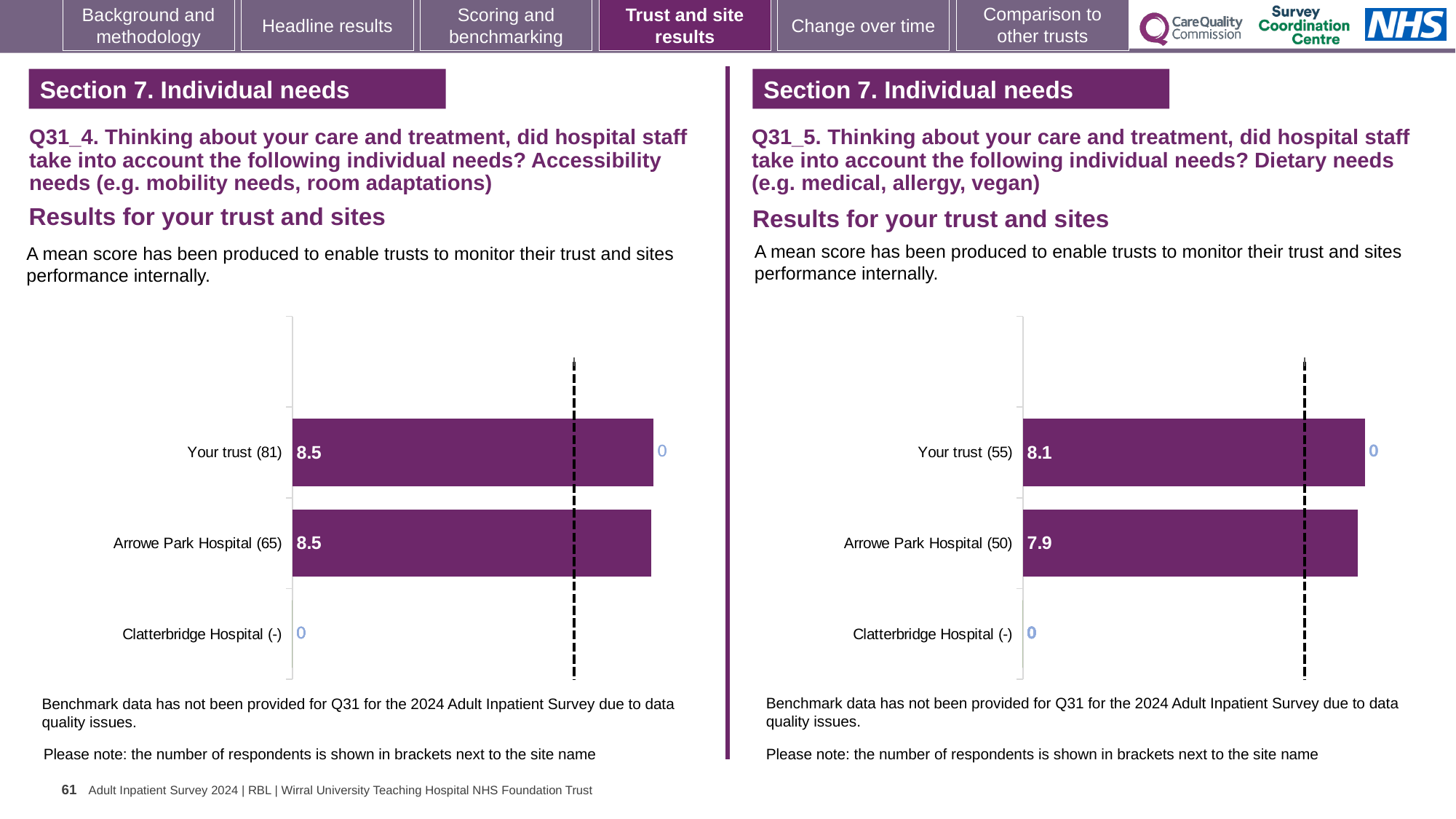
On the right chart (Q31_5, Dietary needs), which has the higher mean score: Your trust (55) or Arrowe Park Hospital (50)? Your trust (55) On the right chart (Q31_5, Dietary needs), what is the mean score for Your trust (55)? 8.1 On the left chart (Q31_4, Accessibility needs), what is the mean score for Arrowe Park Hospital (65)? 8.5 On the left chart (Q31_4, Accessibility needs), what is the mean score for Your trust (81)? 8.5 What kind of chart is used on the left side of the slide (Q31_4)? Bar chart On the right chart (Q31_5, Dietary needs), how many respondents are shown in brackets for Arrowe Park Hospital? 50 On the left chart (Q31_4, Accessibility needs), how many categories are shown on the vertical axis? 3 On the right chart (Q31_5, Dietary needs), how many categories are shown on the vertical axis? 3 On the left chart (Q31_4, Accessibility needs), how many respondents are shown in brackets for Your trust? 81 On the right chart (Q31_5, Dietary needs), what is the difference between the mean scores for Your trust (55) and Arrowe Park Hospital (50)? 0.2 On the right chart (Q31_5, Dietary needs), what is the mean score for Arrowe Park Hospital (50)? 7.9 On the left chart (Q31_4, Accessibility needs), what value is shown for Clatterbridge Hospital (-)? 0